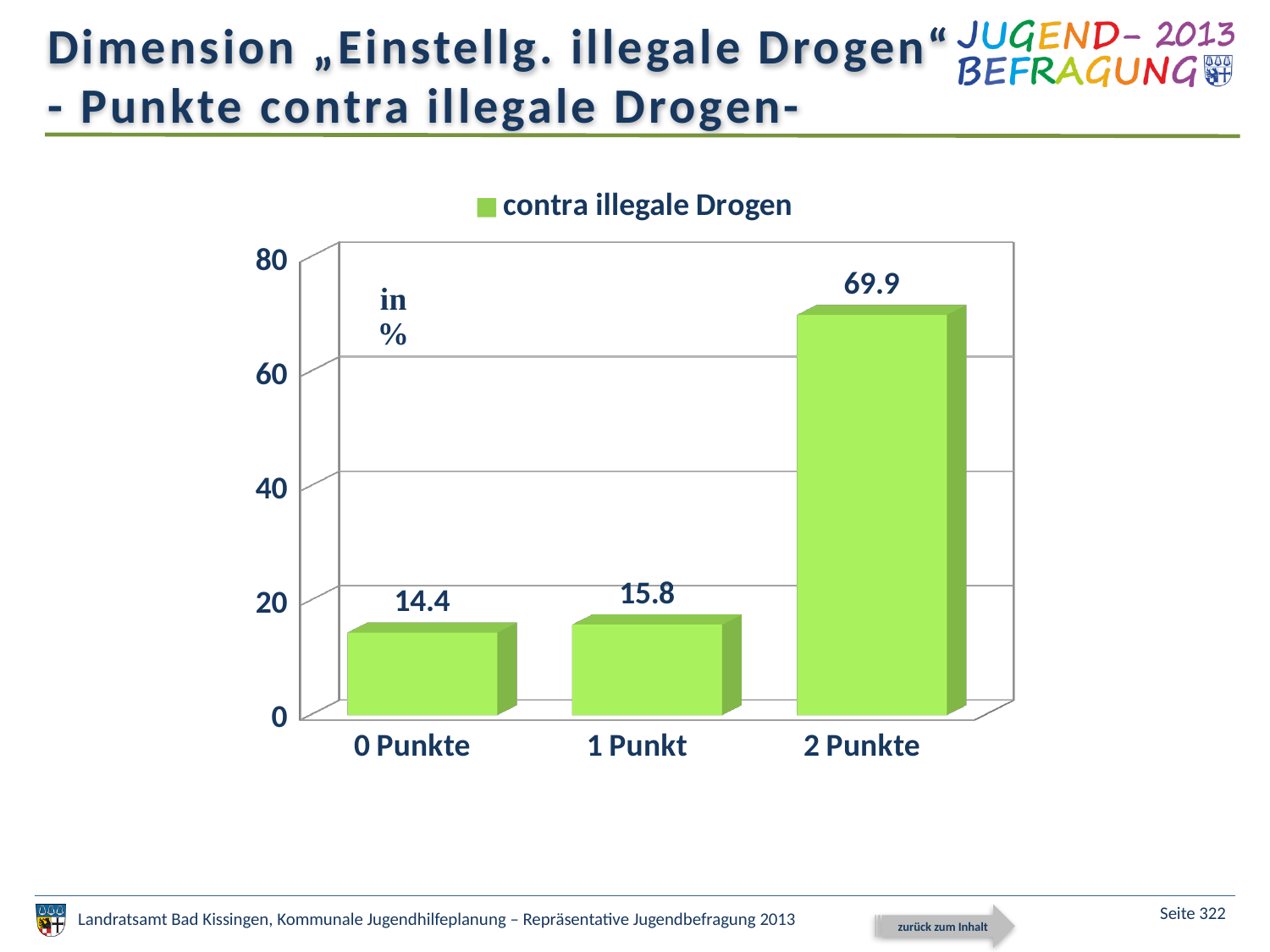
What is the difference between the values for 1 Punkt and 0 Punkte? 1.4 Is the value for 2 Punkte greater or less than 60? greater Which is larger, the value for 1 Punkt or the value for 0 Punkte? 1 Punkt What is the value for 2 Punkte? 69.9 What is the difference between the values for 2 Punkte and 1 Punkt? 54.1 How many categories are shown on the x axis? 3 Which category has the highest value? 2 Punkte What series name does the legend show? contra illegale Drogen Which category has the lowest value? 0 Punkte What is the value for 1 Punkt? 15.8 What is the value for 0 Punkte? 14.4 What kind of chart is shown on the slide? bar chart